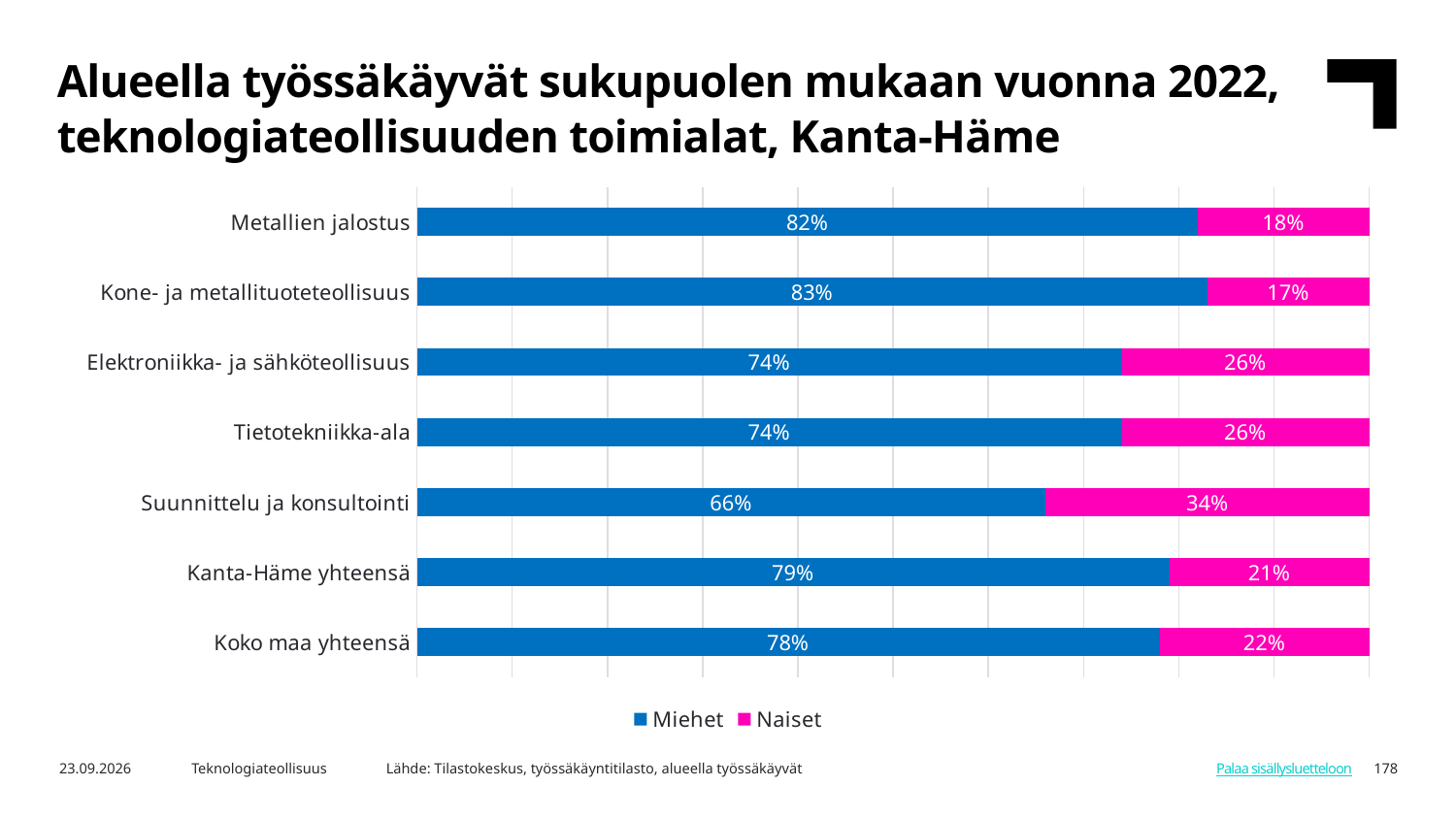
Which category has the lowest Miehet share? Suunnittelu ja konsultointi Which category has the highest Miehet share? Kone- ja metallituoteteollisuus What is the Miehet share for Koko maa yhteensä? 78% How many categories are shown on the chart? 7 What is the Naiset share for Kone- ja metallituoteteollisuus? 17% What kind of chart is shown on the slide? Stacked bar chart What is the Miehet share for Metallien jalostus? 82% What is the difference in percentage points between the Naiset share for Suunnittelu ja konsultointi and for Metallien jalostus? 16 What is the Naiset share for Suunnittelu ja konsultointi? 34% Which has a larger Naiset share, Kanta-Häme yhteensä or Koko maa yhteensä? Koko maa yhteensä Which colour represents Naiset in the chart? Magenta (pink) How many series does the legend list? 2